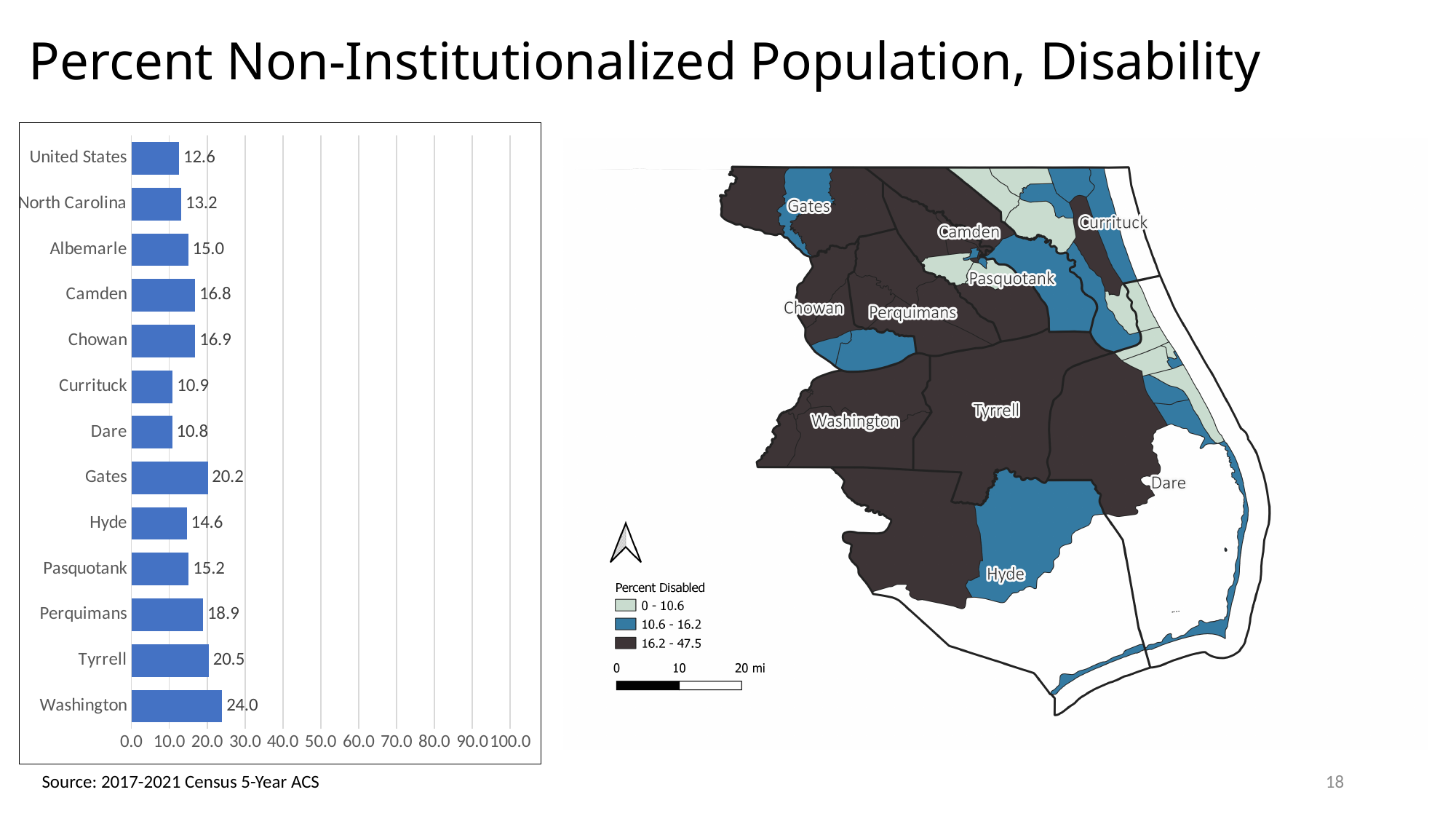
What is the difference between the values for Tyrrell and Hyde in the bar chart? 5.9 What is the value for Gates in the bar chart? 20.2 Is the value for Camden in the bar chart greater or less than 20.0? less What is the value for North Carolina in the bar chart? 13.2 Which category has the highest value in the bar chart? Washington How many categories are shown in the bar chart? 13 Which category has the lowest value in the bar chart? Dare What is the difference between the values for Albemarle and the United States in the bar chart? 2.4 What kind of chart is shown on the left of the slide? Bar chart What is the value for Washington in the bar chart? 24.0 Which has a larger value in the bar chart, Perquimans or Pasquotank? Perquimans What is the highest value shown on the x axis of the bar chart? 100.0